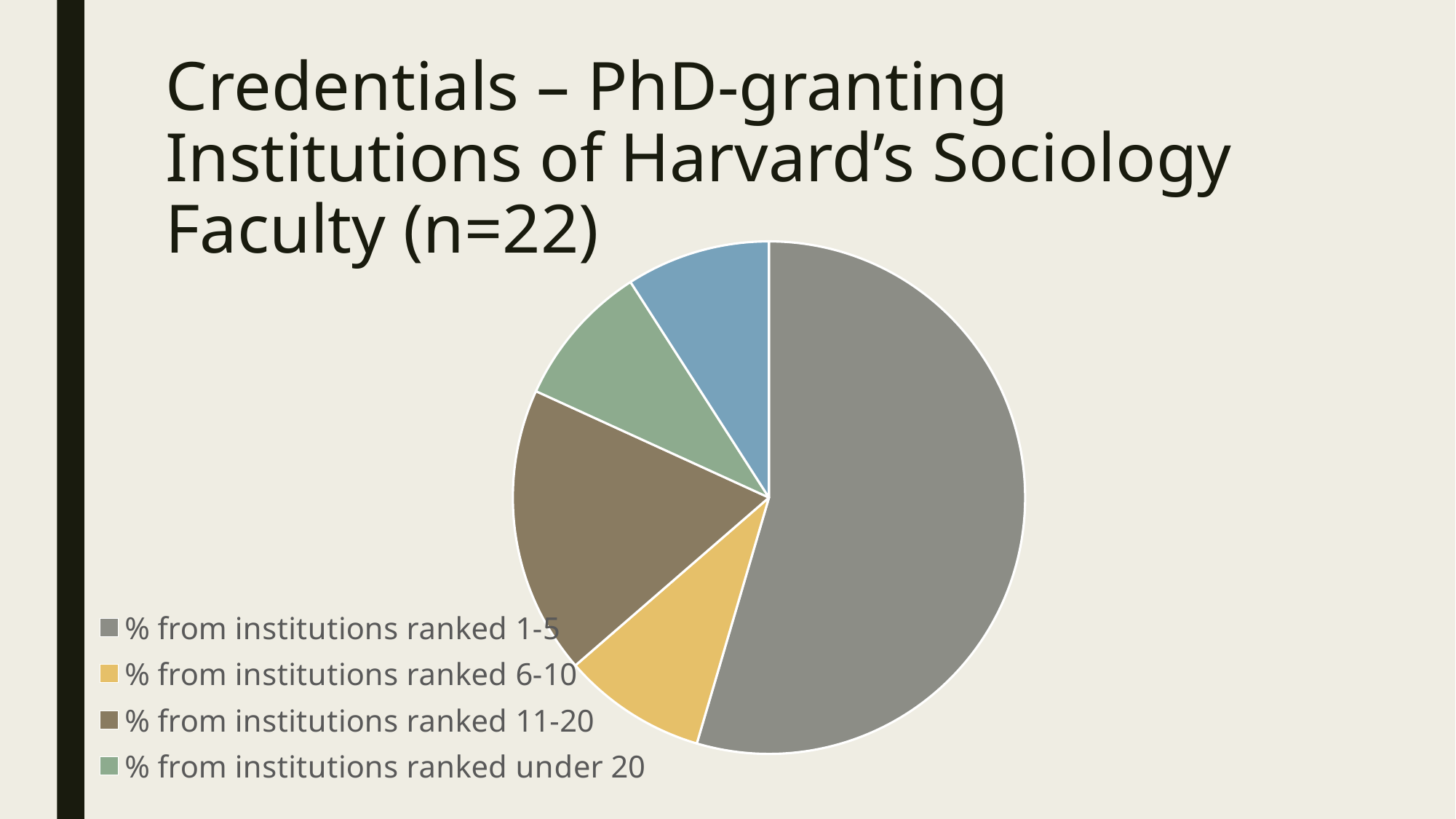
Which slice is larger: % from institutions ranked 1-5 or % from institutions ranked 11-20? % from institutions ranked 1-5 What colour represents % from institutions ranked 6-10 in the legend? yellow What is the title of the slide containing the pie chart? Credentials – PhD-granting Institutions of Harvard's Sociology Faculty (n=22) How many entries does the legend list? 4 Which category has the largest slice of the pie? % from institutions ranked 1-5 What kind of chart is shown on the slide? pie chart Which category has the second-largest slice of the pie? % from institutions ranked 11-20 Which slice is larger: % from institutions ranked 11-20 or % from institutions ranked 6-10? % from institutions ranked 11-20 Does the largest slice of the pie take up more or less than half of the pie? more